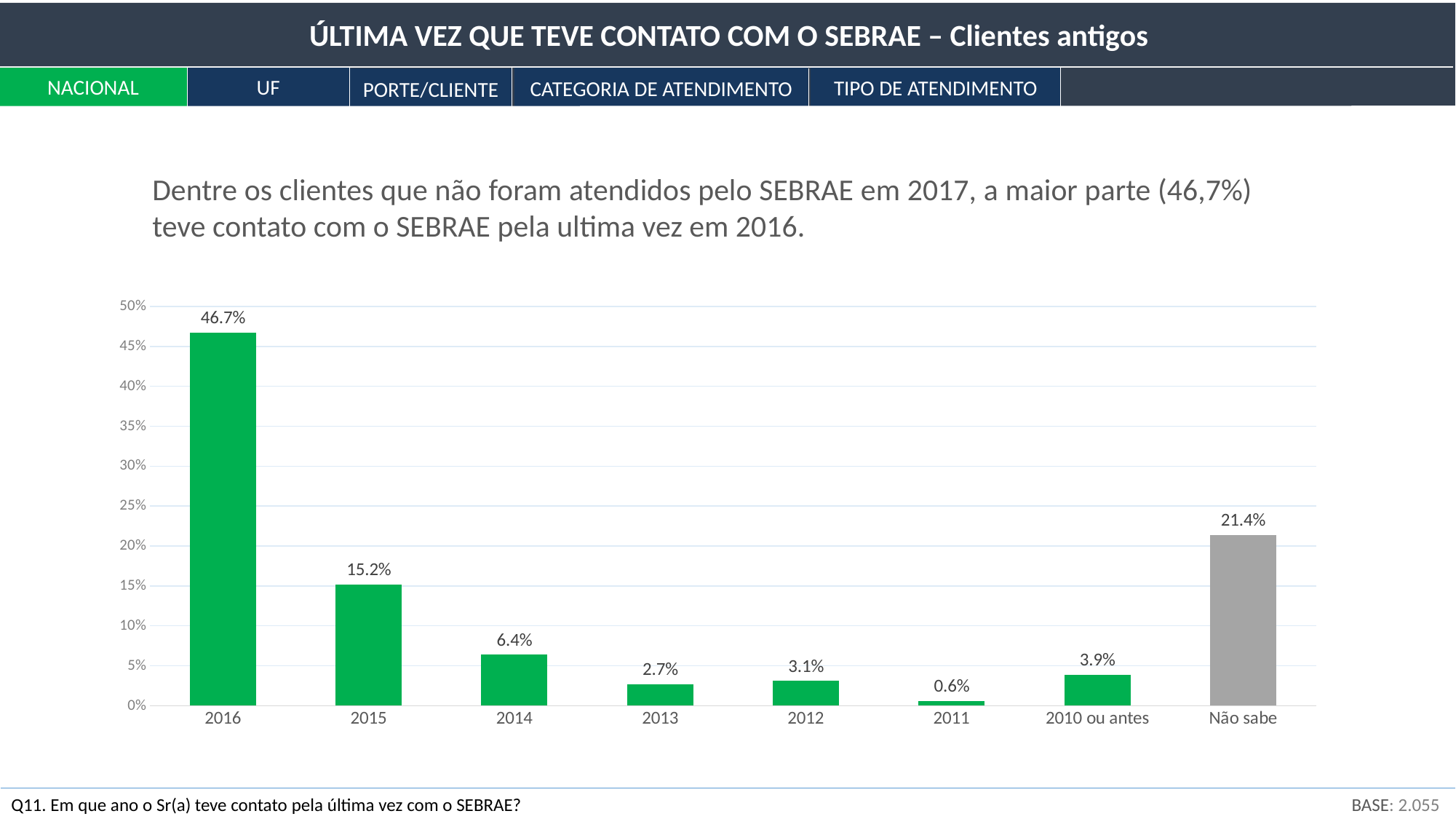
Which is larger, the value for 2012 or the value for 2013? 2012 Which bar is coloured grey instead of green? Não sabe How many categories are shown on the x axis? 8 What is the value for '2010 ou antes'? 3.9% What is the value for 2015? 15.2% What is the value for 'Não sabe'? 21.4% What kind of chart is shown on the slide? bar chart Is the value for 2014 greater or less than 5%? greater What is the difference between the values for 2016 and 2015? 31.5% Which category has the highest value? 2016 Which category has the lowest value? 2011 What is the value for 2016? 46.7%